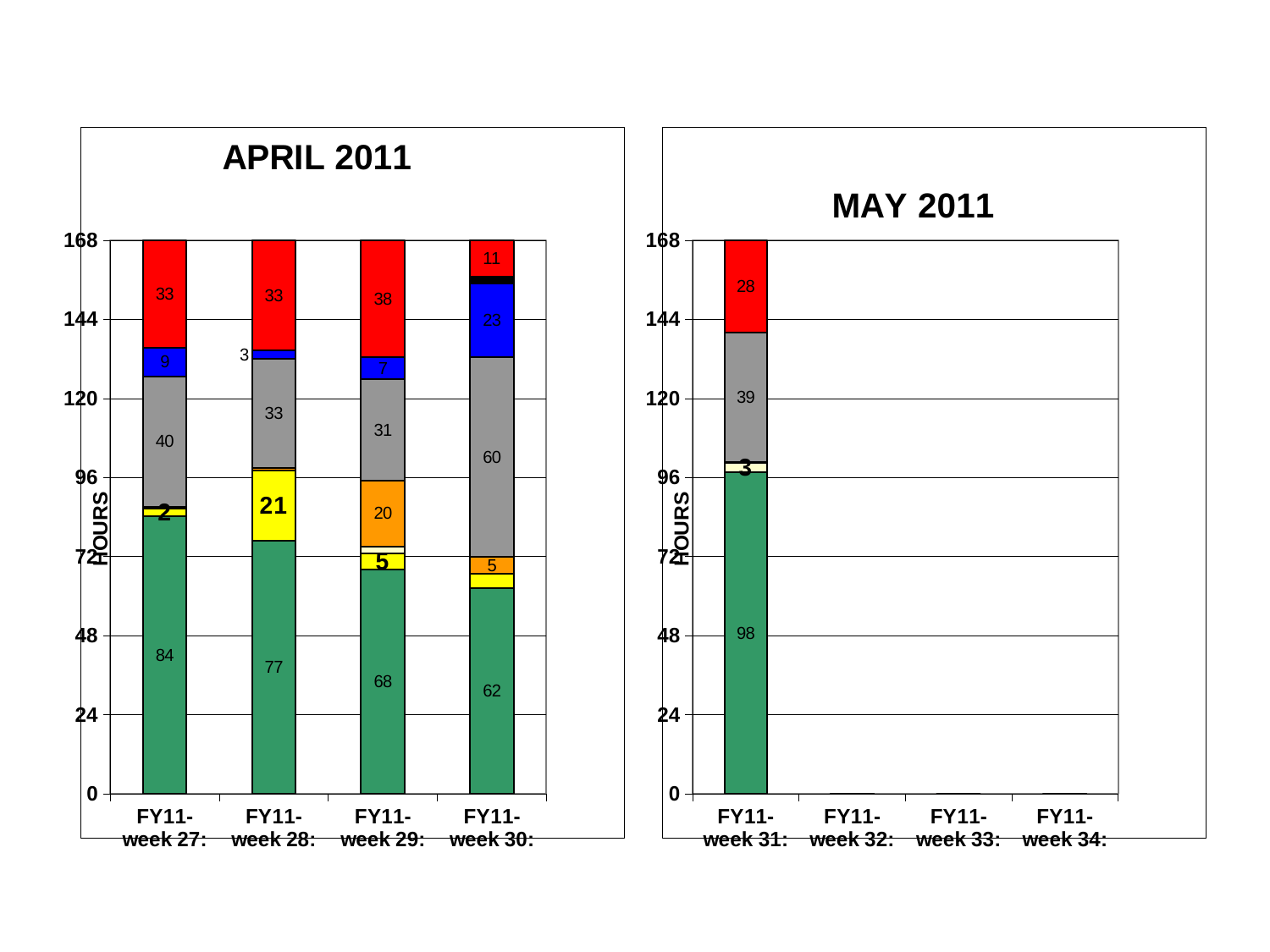
In the MAY 2011 chart, what is the value of the grey segment for FY11-week 31? 39 In the APRIL 2011 chart, is the grey segment larger for FY11-week 30 or FY11-week 27? FY11-week 30 In the APRIL 2011 chart, which week has the smallest green segment? FY11-week 30 What kind of chart is the APRIL 2011 chart? stacked bar chart In the APRIL 2011 chart, what is the difference between the green segments for FY11-week 27 and FY11-week 28? 7 In the APRIL 2011 chart, what is the value of the green segment for FY11-week 27? 84 In the APRIL 2011 chart, what is the value of the red segment for FY11-week 29? 38 How many week categories are shown on the x axis of the APRIL 2011 chart? 4 In the APRIL 2011 chart, which week has the largest green segment? FY11-week 27 In the MAY 2011 chart, what is the total of the stacked bar for FY11-week 31? 168 What is the y-axis title on the MAY 2011 chart? HOURS In the MAY 2011 chart, what is the value of the green segment for FY11-week 31? 98